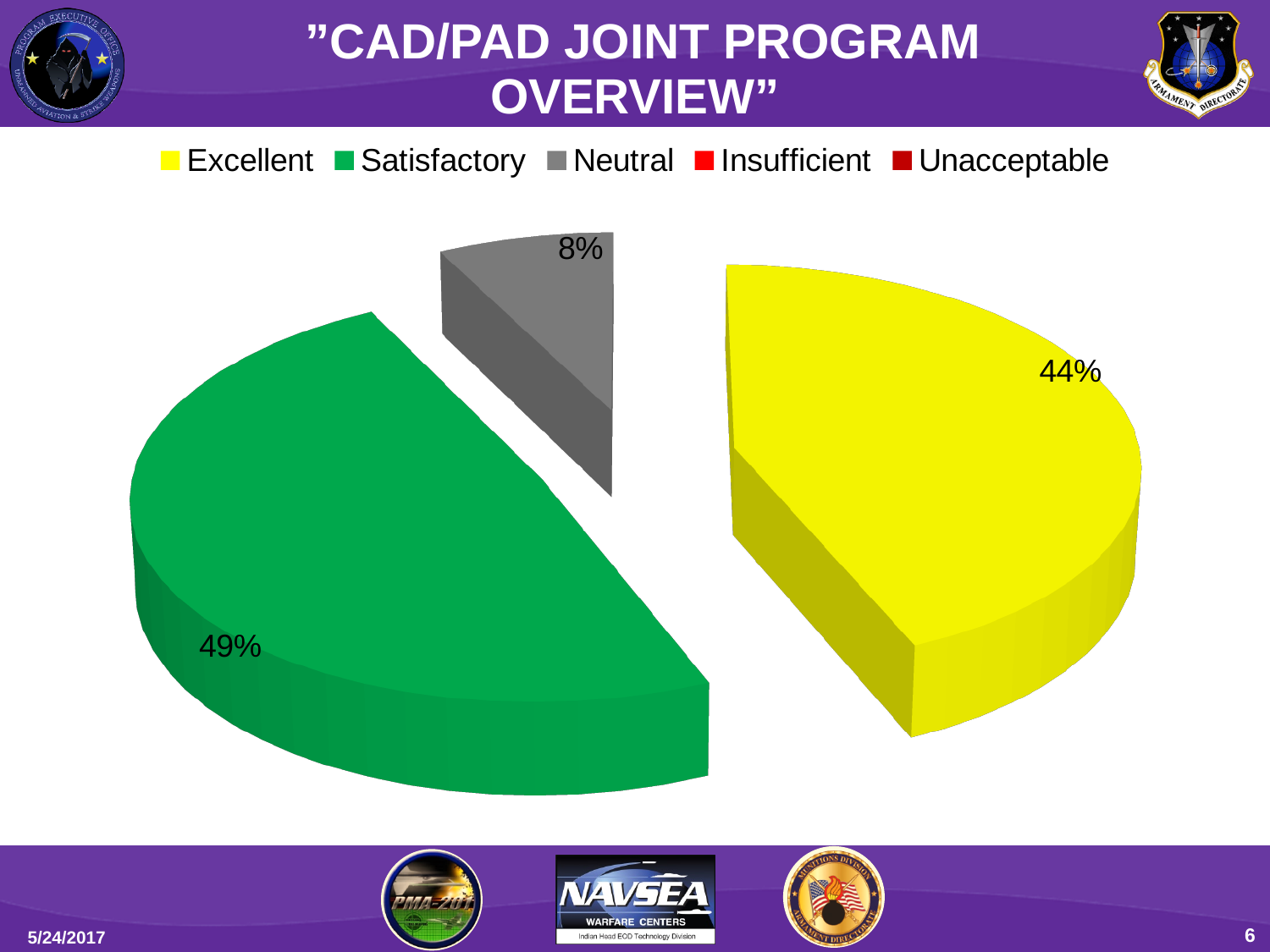
What colour represents the Excellent category in the legend? Yellow What is the difference in percentage points between the Satisfactory and Excellent slices? 5 What percentage does the Neutral slice show? 8% Of the slices with printed labels, which category has the smallest share? Neutral What is the difference in percentage points between the Excellent and Neutral slices? 36 How many slices are visibly plotted in the pie? 3 Which is larger, the Excellent slice or the Neutral slice? Excellent How many entries does the legend list? 5 What percentage does the Satisfactory slice show? 49% Which category has the largest slice of the pie? Satisfactory What percentage does the Excellent slice show? 44% What kind of chart is shown on the slide? Pie chart